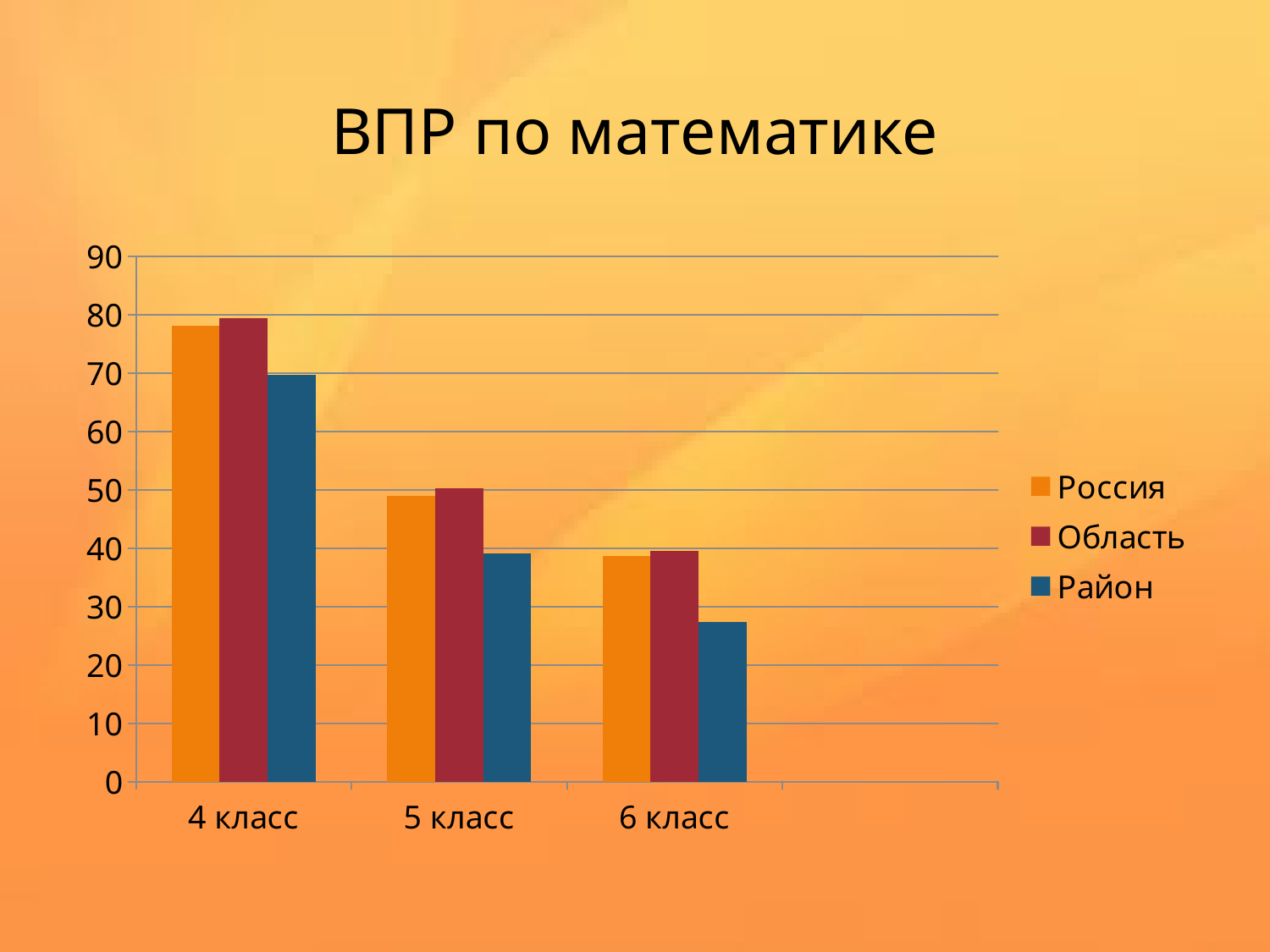
Is the value for Район in 5 класс greater or less than 50? less What kind of chart is shown on the slide? bar chart Is the value for Область in 4 класс greater or less than 70? greater Do the values for Россия rise or fall from 4 класс to 6 класс? fall How many series does the legend list? 3 Is the value for Район in 4 класс greater or less than 60? greater Which series is shown in blue? Район How many categories are shown on the x axis? 3 For the Район series, which category has the highest value? 4 класс What is the title of the chart? ВПР по математике Which is larger in 4 класс, Россия or Район? Россия